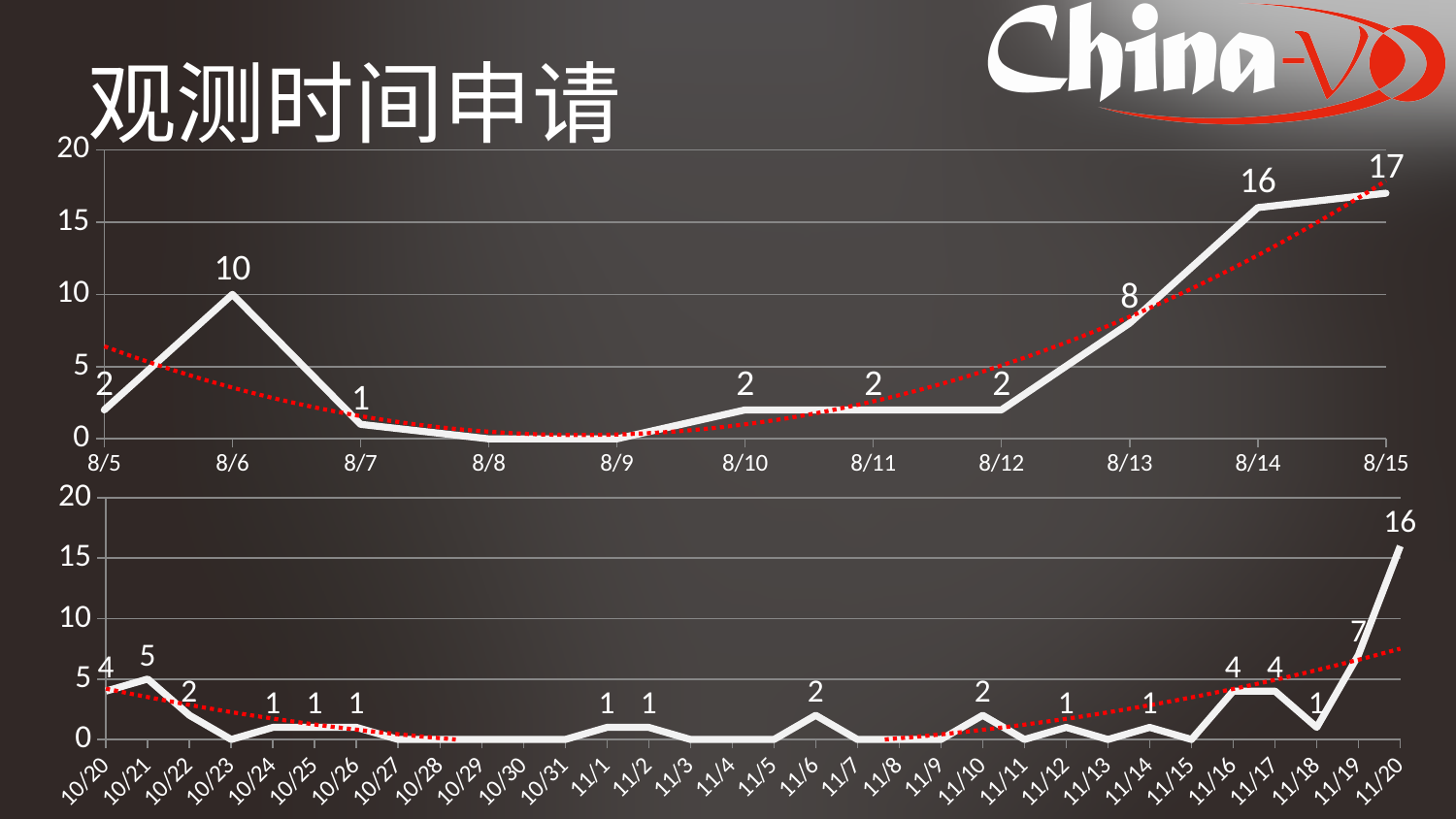
On the bottom chart, what is the value for 10/21? 5 On the top chart, what is the difference between the values for 8/15 and 8/13? 9 What type of chart is the top chart? Line chart On the top chart, which is larger, the value for 8/6 or the value for 8/13? 8/6 On the bottom chart, which date has the highest value? 11/20 On the bottom chart, is the value for 11/20 greater or less than 15? greater On the bottom chart, what is the value for 11/20? 16 On the top chart, what is the value for 8/6? 10 On the bottom chart, what is the difference between the values for 11/20 and 11/19? 9 On the top chart, which date has the highest value? 8/15 On the top chart, how many dates are shown on the x axis? 11 On the top chart, what is the value for 8/14? 16